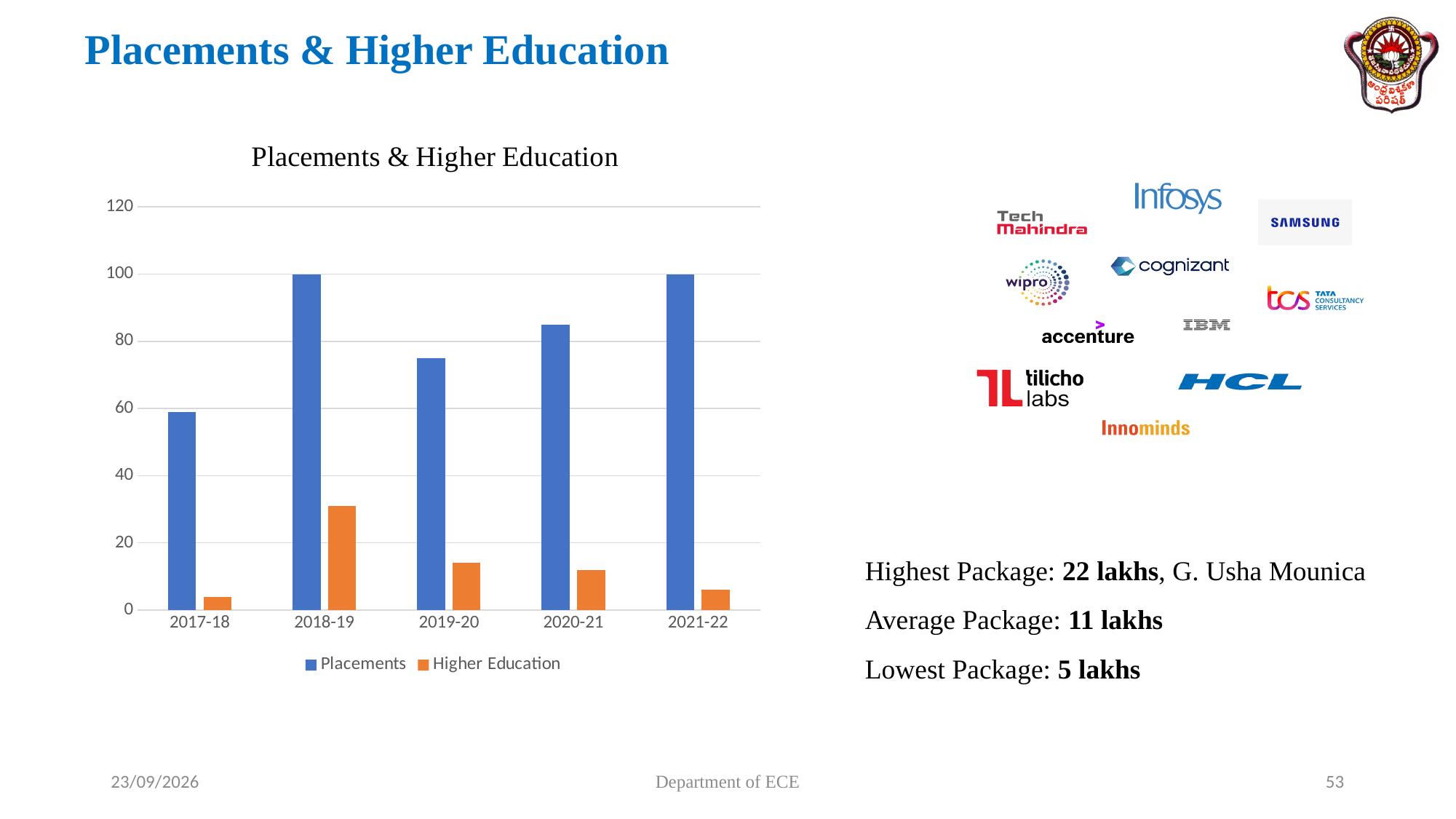
Which year has the highest Higher Education value? 2018-19 Which year has the lowest Placements value? 2017-18 Is the Placements value for 2020-21 greater or less than 80? greater How many series does the chart legend list? 2 What type of chart is shown on the slide? bar chart What is the Placements value for 2018-19? 100 Which is larger, the Placements value for 2019-20 or for 2020-21? 2020-21 What is the Placements value for 2021-22? 100 Is the Higher Education value for 2018-19 greater or less than 20? greater How many academic years are shown on the x axis of the chart? 5 What is the title of the chart? Placements & Higher Education